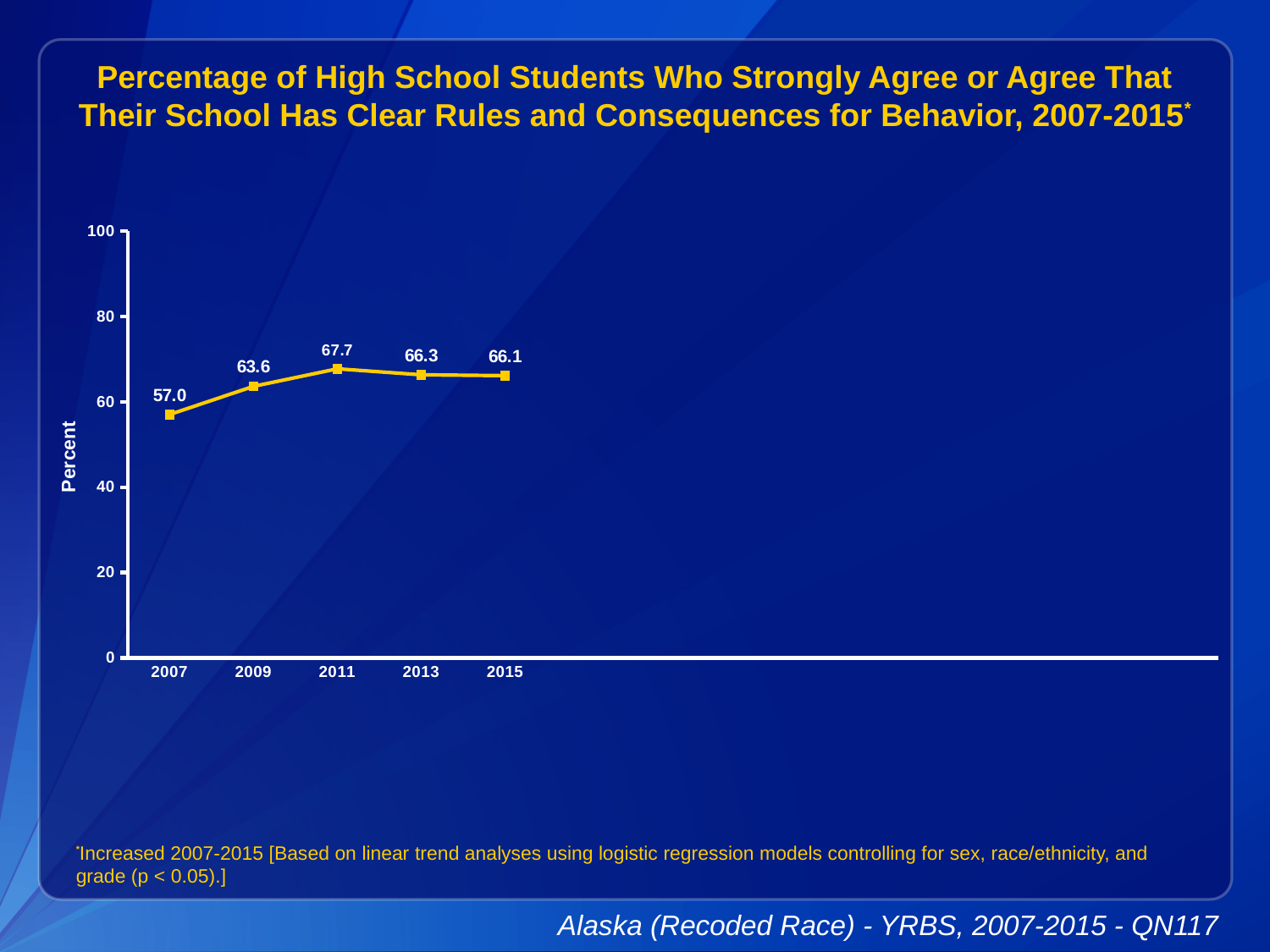
Which is larger, the value for 2009 or the value for 2013? 2013 What is the difference between the values for 2011 and 2007? 10.7 What is the value for 2007? 57.0 What is the value for 2011? 67.7 Which year has the lowest value? 2007 What kind of chart is shown? line chart How many years are plotted on the chart? 5 Which year has the highest value? 2011 Do the values rise or fall from 2007 to 2011? rise What is the value for 2015? 66.1 What is the label on the y axis? Percent Is the value for 2007 greater or less than 60? less